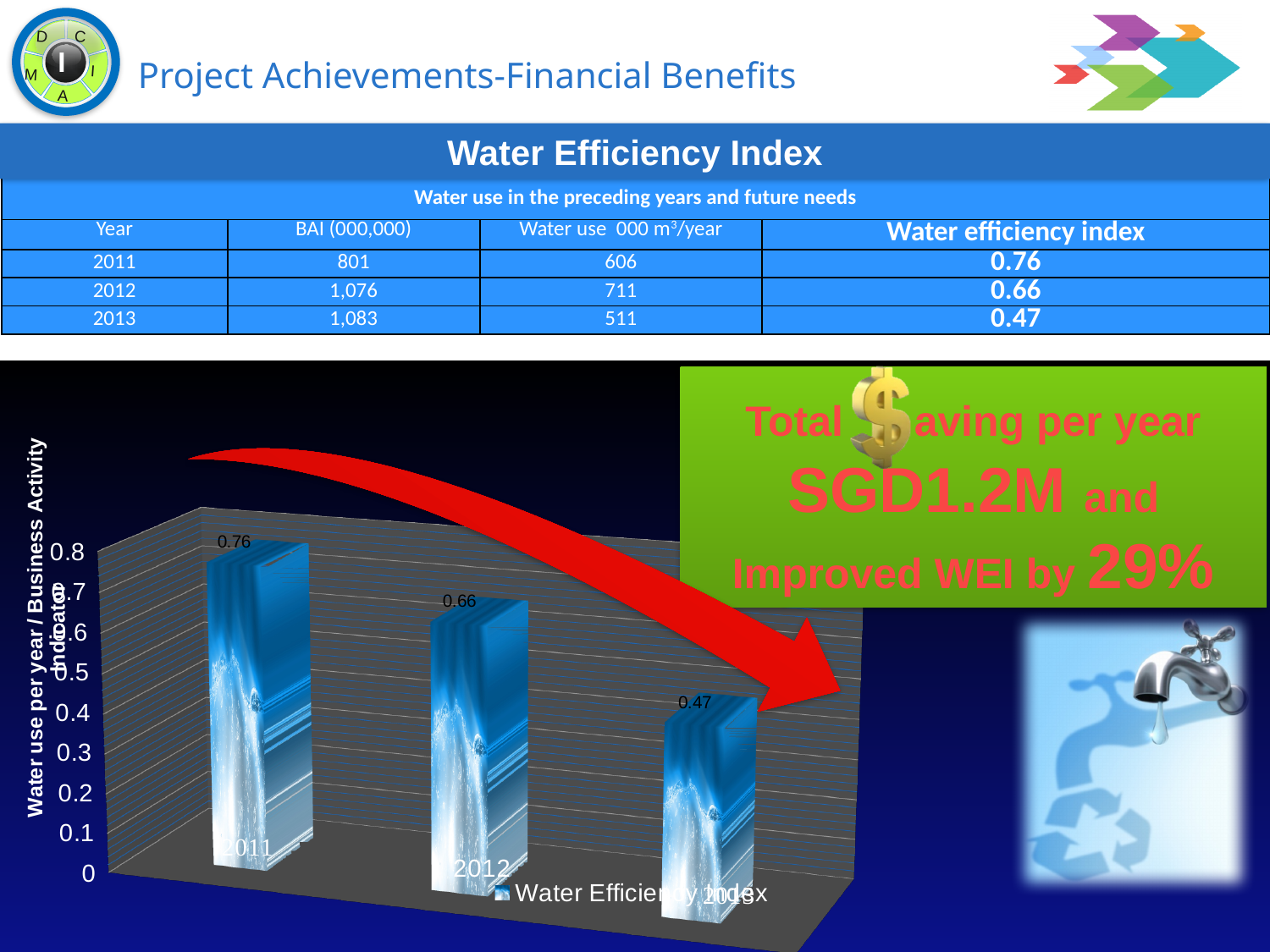
What is the difference between the Water Efficiency Index for 2011 and 2013? 0.29 Which year has the lowest Water Efficiency Index in the chart? 2013 Is the Water Efficiency Index for 2013 greater or less than 0.5? less Which year has the highest Water Efficiency Index in the chart? 2011 Do the Water Efficiency Index values rise or fall from 2011 to 2013? fall What kind of chart is used to show the Water Efficiency Index? bar chart What is the Water Efficiency Index value shown for 2012 in the chart? 0.66 How many years are plotted in the chart? 3 Which is larger, the Water Efficiency Index for 2012 or for 2013? 2012 What is the difference between the Water Efficiency Index for 2011 and 2012? 0.10 What is the Water Efficiency Index value shown for 2013 in the chart? 0.47 What is the Water Efficiency Index value shown for 2011 in the chart? 0.76